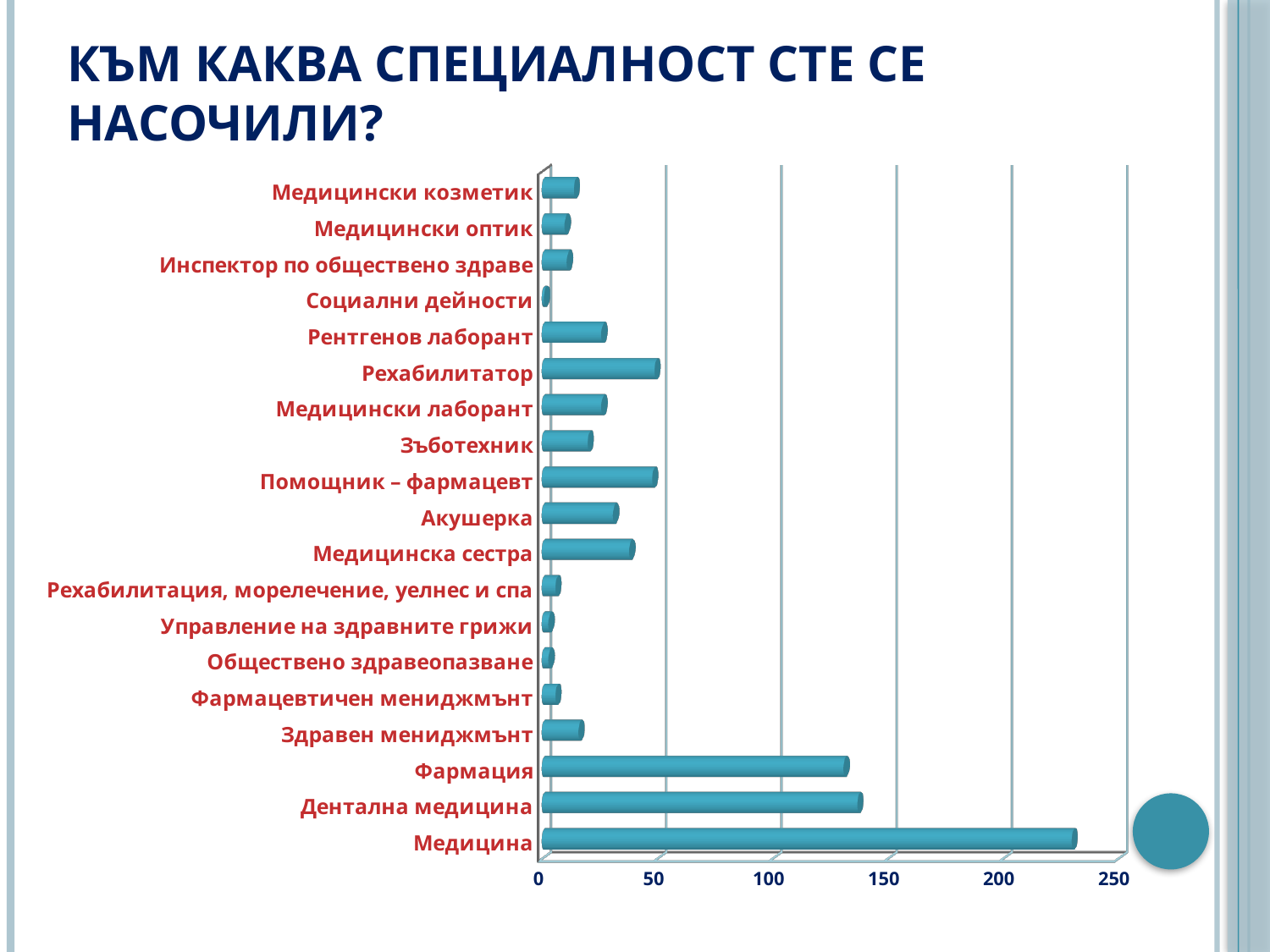
What is the title of the slide containing the chart? КЪМ КАКВА СПЕЦИАЛНОСТ СТЕ СЕ НАСОЧИЛИ? Which has a larger value, Медицинска сестра or Акушерка? Медицинска сестра Which has a larger value, Медицина or Фармация? Медицина Is the value for Здравен мениджмънт greater or less than 50? less Is the value for Дентална медицина greater or less than 100? greater Is the value for Медицина greater or less than 200? greater What kind of chart is shown on the slide? bar chart Which specialty has the highest value on the chart? Медицина How many specialties (categories) are listed on the chart? 19 Which has a larger value, Рехабилитатор or Зъботехник? Рехабилитатор